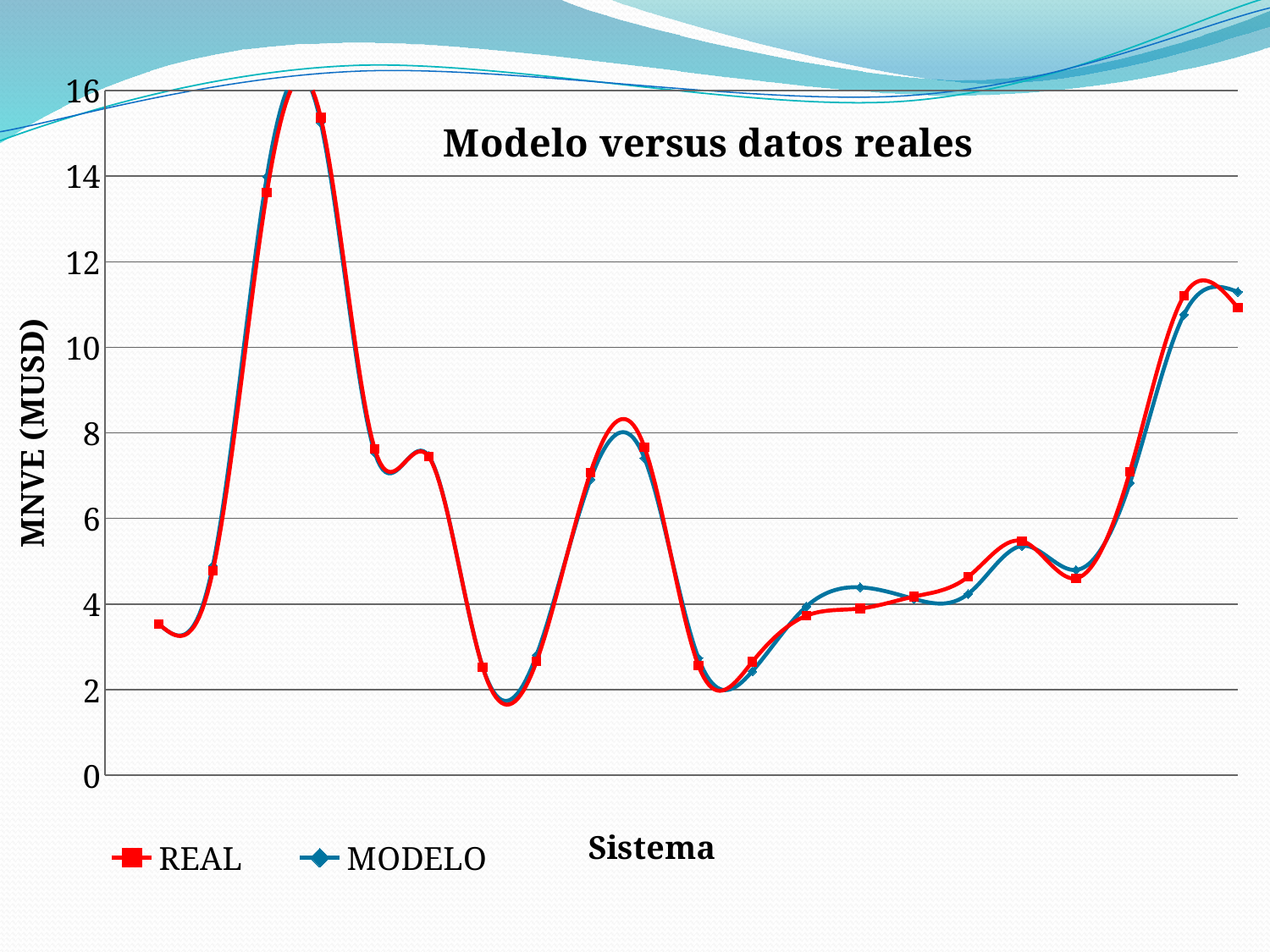
Is the highest peak of the REAL series greater or less than 14? greater Is the value of the last REAL point greater or less than 12? less Is the value of the last MODELO point greater or less than 10? greater What kind of chart is shown on the slide? line chart How many series does the legend list? 2 What is the highest value shown on the vertical axis? 16 What is the label of the vertical axis? MNVE (MUSD) What is the title of the chart? Modelo versus datos reales